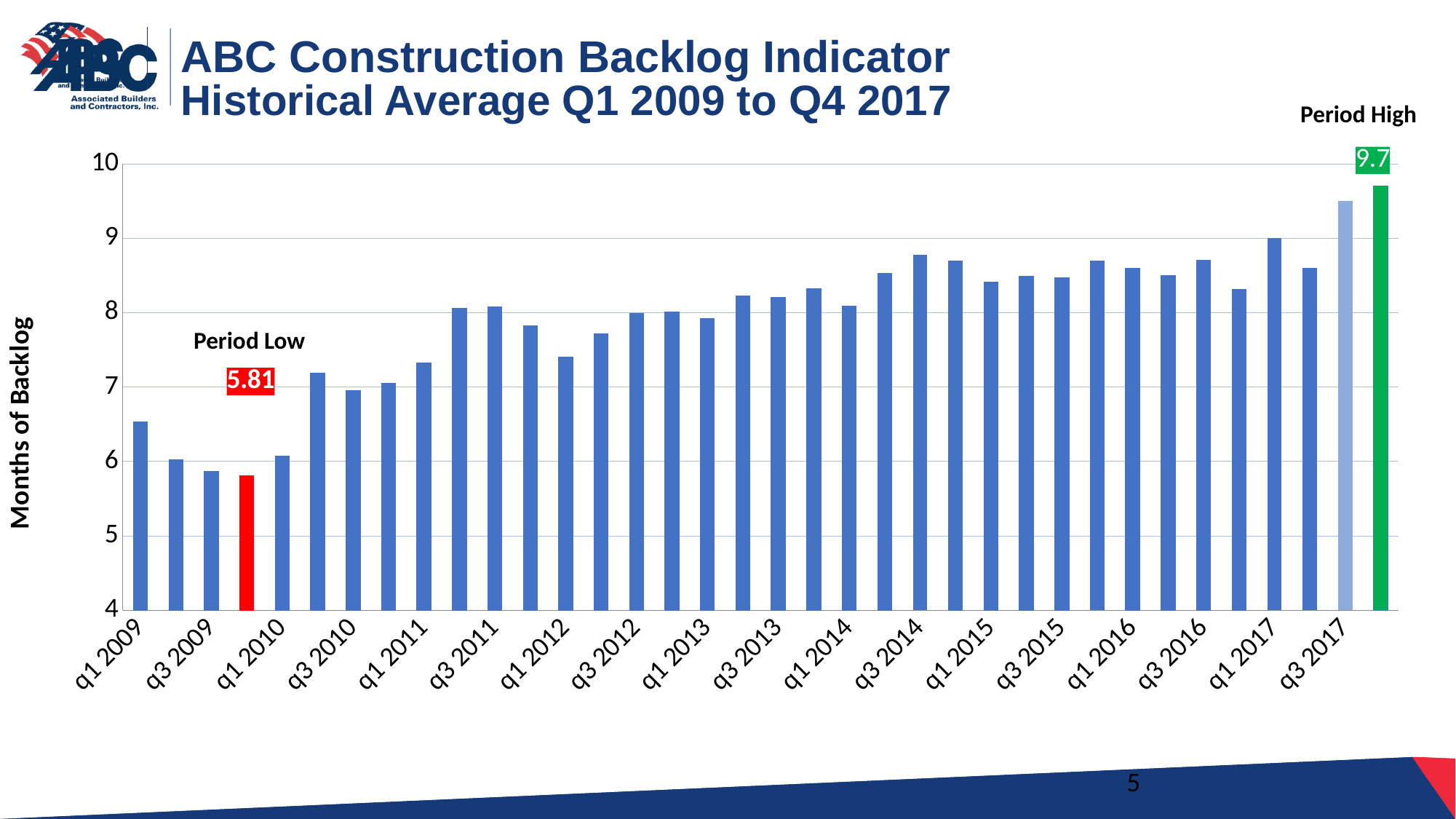
Overall, do the values rise or fall from q1 2009 to q4 2017? Rise What kind of chart is shown on the slide? Bar chart Is the value for q3 2014 greater or less than 8? greater What is the highest value shown on the chart? 9.7 Is the value for q1 2009 greater or less than 6? greater What value is labelled as the Period Low? 5.81 Is the value for q1 2012 greater or less than 8? less What is the title of the vertical axis? Months of Backlog What is the difference between the Period High and the Period Low values? 3.89 Which is larger, the value for q1 2009 or the value for q3 2009? q1 2009 What is the lowest value shown on the chart? 5.81 What value is labelled as the Period High? 9.7